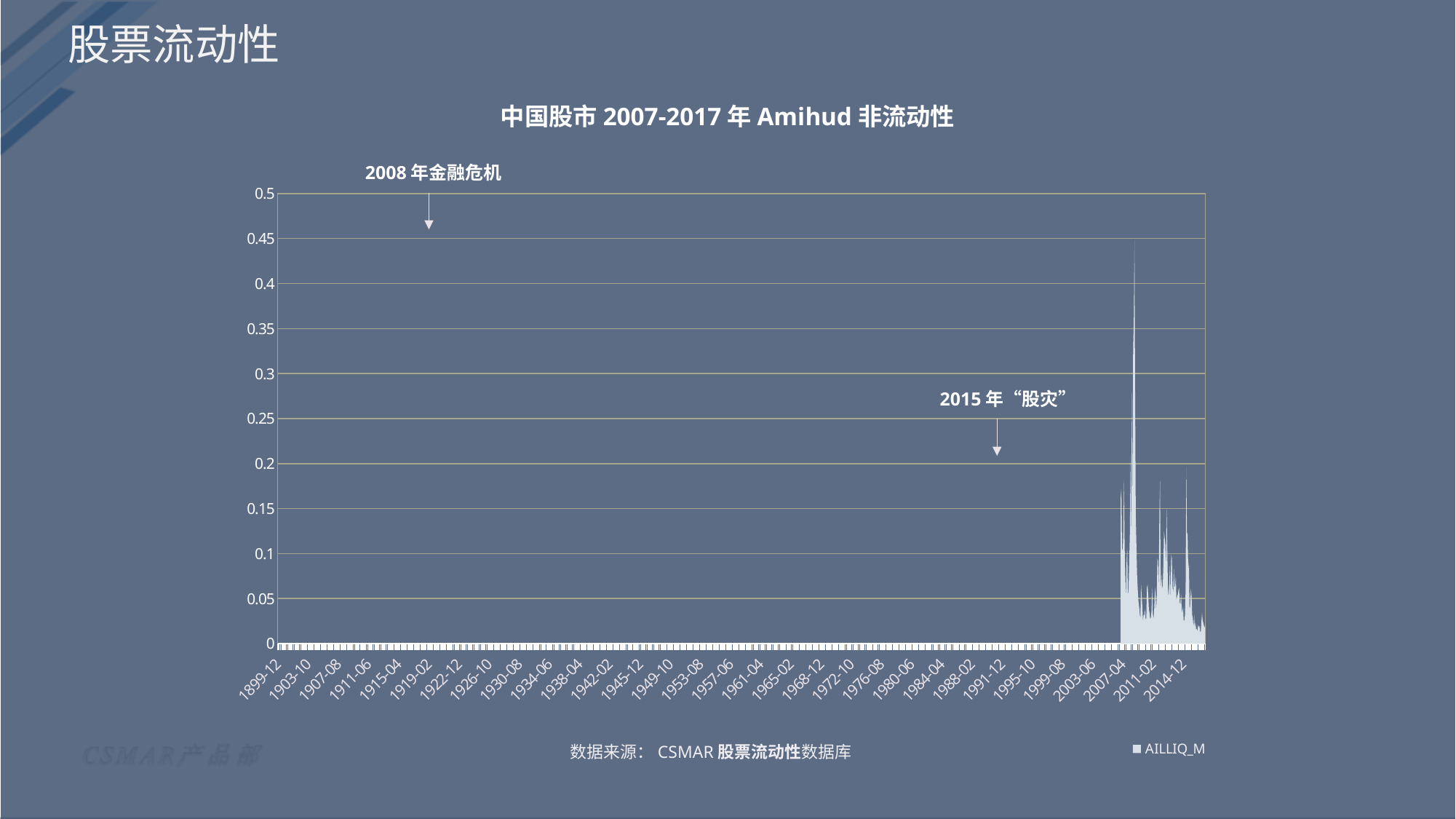
What is the first label on the horizontal axis? 1899-12 What is the title of the chart? 中国股市 2007-2017 年 Amihud 非流动性 Is the peak value of the AILLIQ_M series greater or less than 0.4? greater Which event is annotated near the left side of the chart? 2008 年金融危机 What is the last label on the horizontal axis? 2014-12 Is the peak value of the AILLIQ_M series greater or less than 0.5? less What kind of chart is shown on the slide? area chart What is the lowest value shown on the vertical axis? 0 Which event is annotated near the right side of the chart? 2015 年“股灾” How many series does the legend list? 1 What is the highest value shown on the vertical axis? 0.5